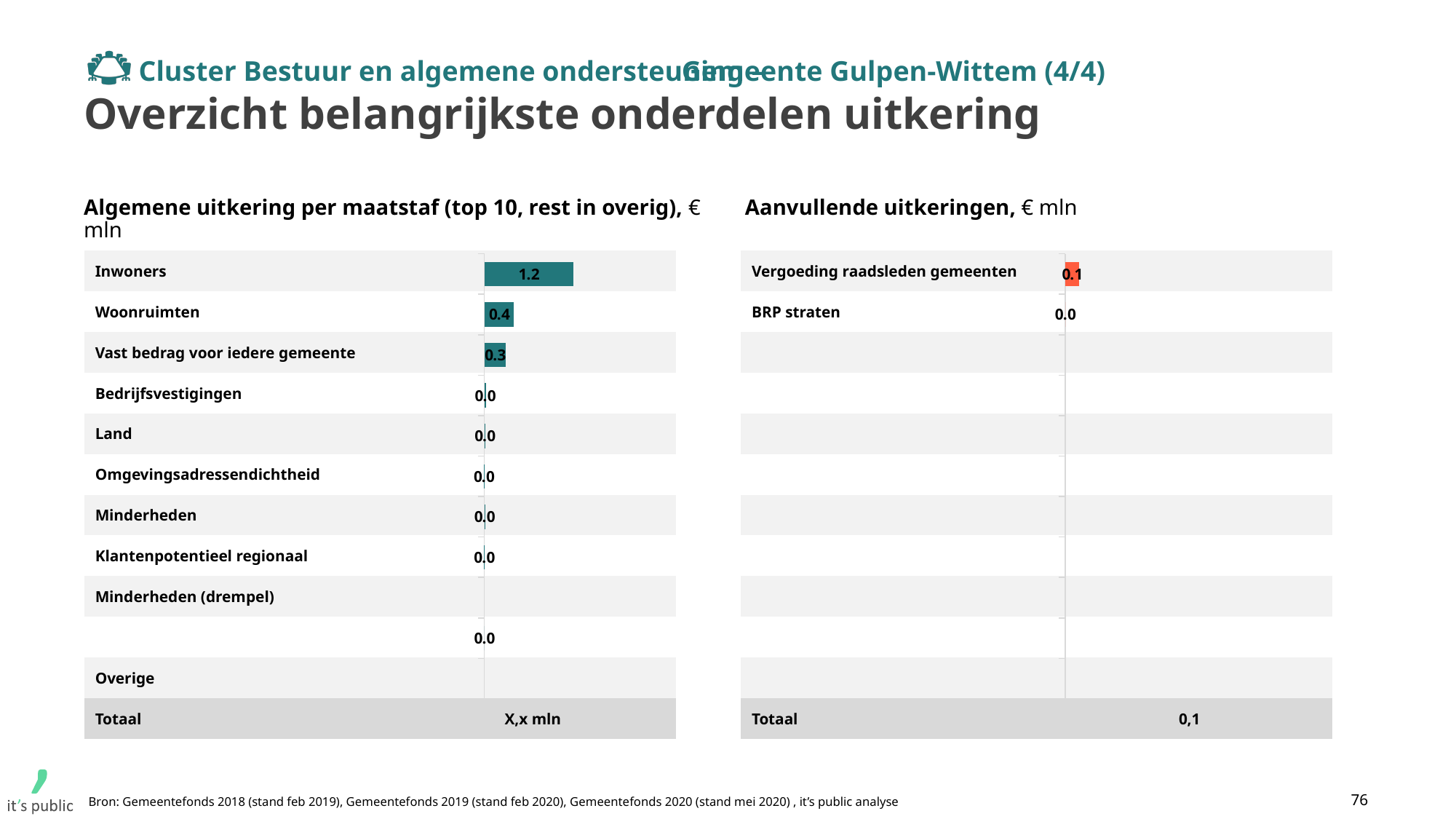
In the chart 'Algemene uitkering per maatstaf', what is the value for Vast bedrag voor iedere gemeente? 0.3 In the chart 'Algemene uitkering per maatstaf', what is the difference between the values for Inwoners and Woonruimten? 0.8 In the chart 'Algemene uitkering per maatstaf', what is the value for Bedrijfsvestigingen? 0.0 What kind of chart is the 'Aanvullende uitkeringen' chart? Bar chart In the chart 'Algemene uitkering per maatstaf', which is larger, the value for Woonruimten or the value for Vast bedrag voor iedere gemeente? Woonruimten In the chart 'Algemene uitkering per maatstaf', which category has the highest value? Inwoners In the chart 'Aanvullende uitkeringen', what is the total shown in the Totaal row? 0,1 What unit is stated in the title of the 'Aanvullende uitkeringen' chart? € mln In the chart 'Algemene uitkering per maatstaf', what is the value for Woonruimten? 0.4 In the chart 'Aanvullende uitkeringen', what is the value for Vergoeding raadsleden gemeenten? 0.1 In the chart 'Aanvullende uitkeringen', what is the value for BRP straten? 0.0 In the chart 'Algemene uitkering per maatstaf', what is the value for Inwoners? 1.2